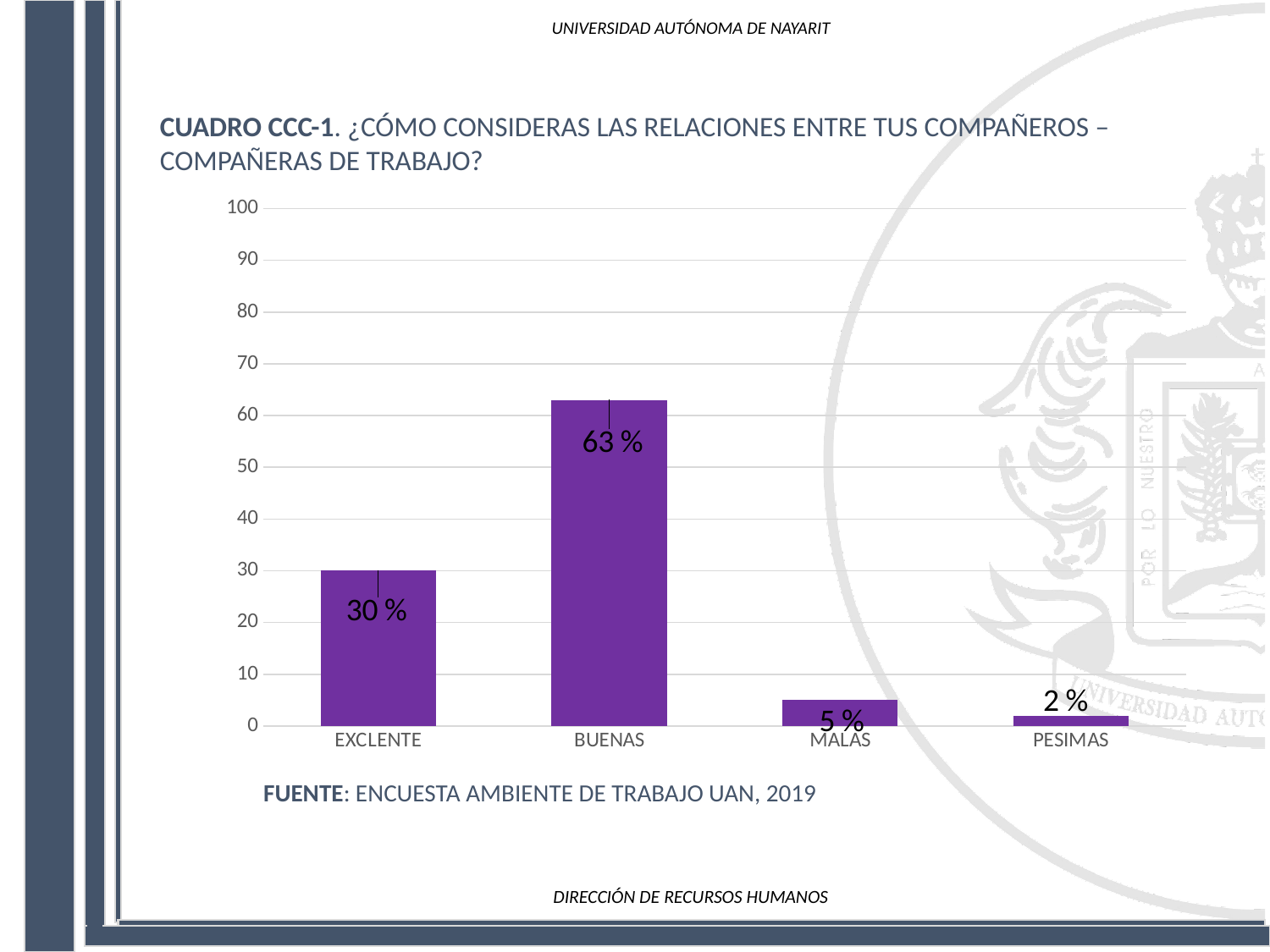
What is the value for PESIMAS? 2 % What is the difference between the values for BUENAS and EXCLENTE? 33 % What is the value for BUENAS? 63 % How many categories are shown on the x axis? 4 Which category has the lowest value? PESIMAS What kind of chart is shown on the slide? bar chart What is the value for MALAS? 5 % Which category has the highest value? BUENAS Which is larger, the value for MALAS or the value for PESIMAS? MALAS Is the value for BUENAS greater or less than 50? greater What is the value for EXCLENTE? 30 % What is the source cited below the chart? ENCUESTA AMBIENTE DE TRABAJO UAN, 2019